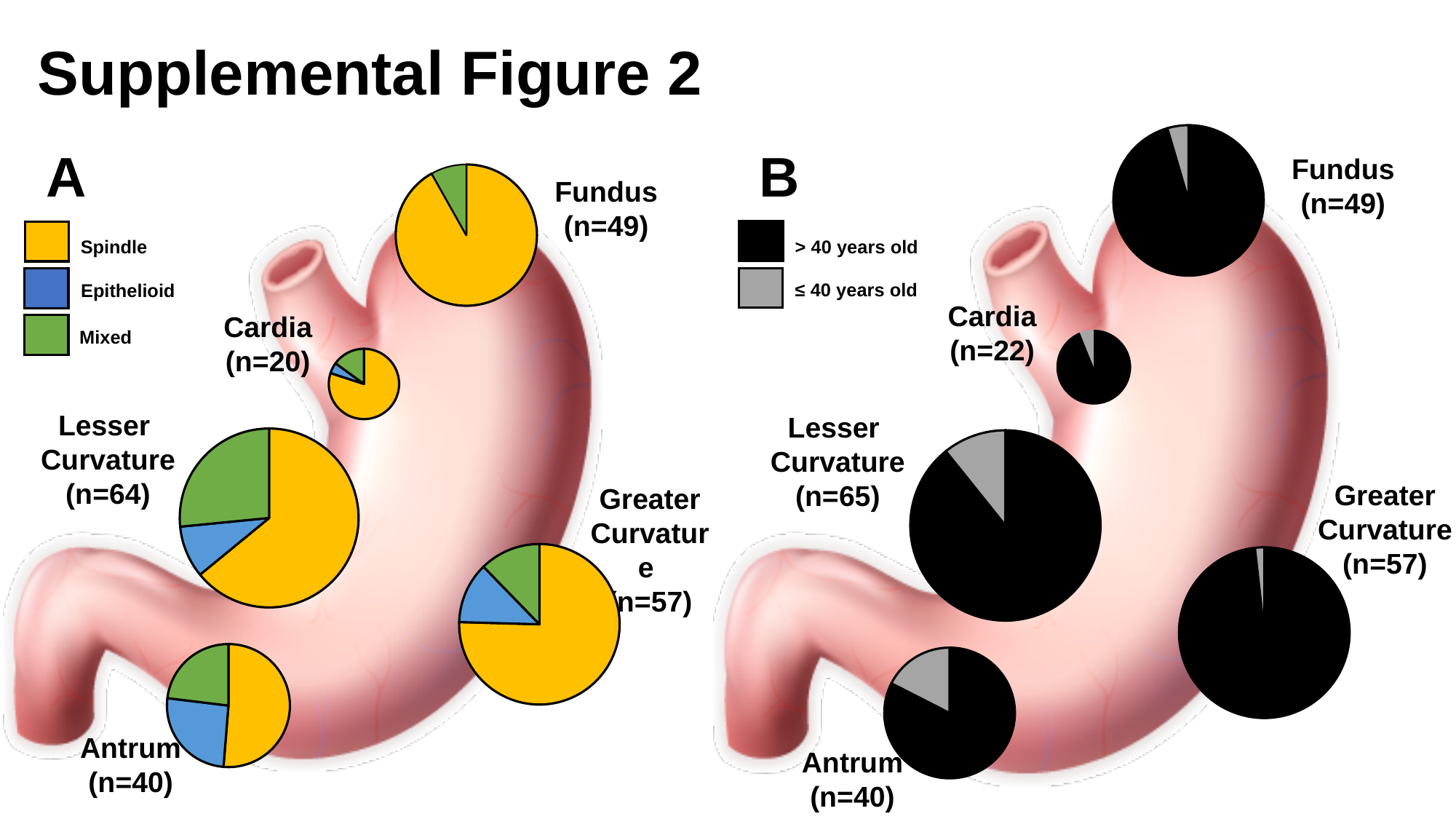
How many pie charts are shown in panel A? 5 In panel B, what is the n value for the Cardia pie chart? n=22 In panel A, what is the n value for the Lesser Curvature pie chart? n=64 How many categories does the legend in panel A list? 3 In panel A, which stomach location has the smallest n value? Cardia (n=20) In panel A, which has a larger n value, Fundus or Greater Curvature? Greater Curvature In panel B, which colour represents patients > 40 years old? Black What kind of chart is used in panel A to show the histologic subtype at each stomach location? Pie chart In panel A, what is the difference between the n value for Greater Curvature and the n value for Antrum? 17 How many categories does the legend in panel B list? 2 In panel A's Fundus pie chart, which slice is larger, Spindle or Mixed? Spindle In panel B, which stomach location has the largest n value? Lesser Curvature (n=65)